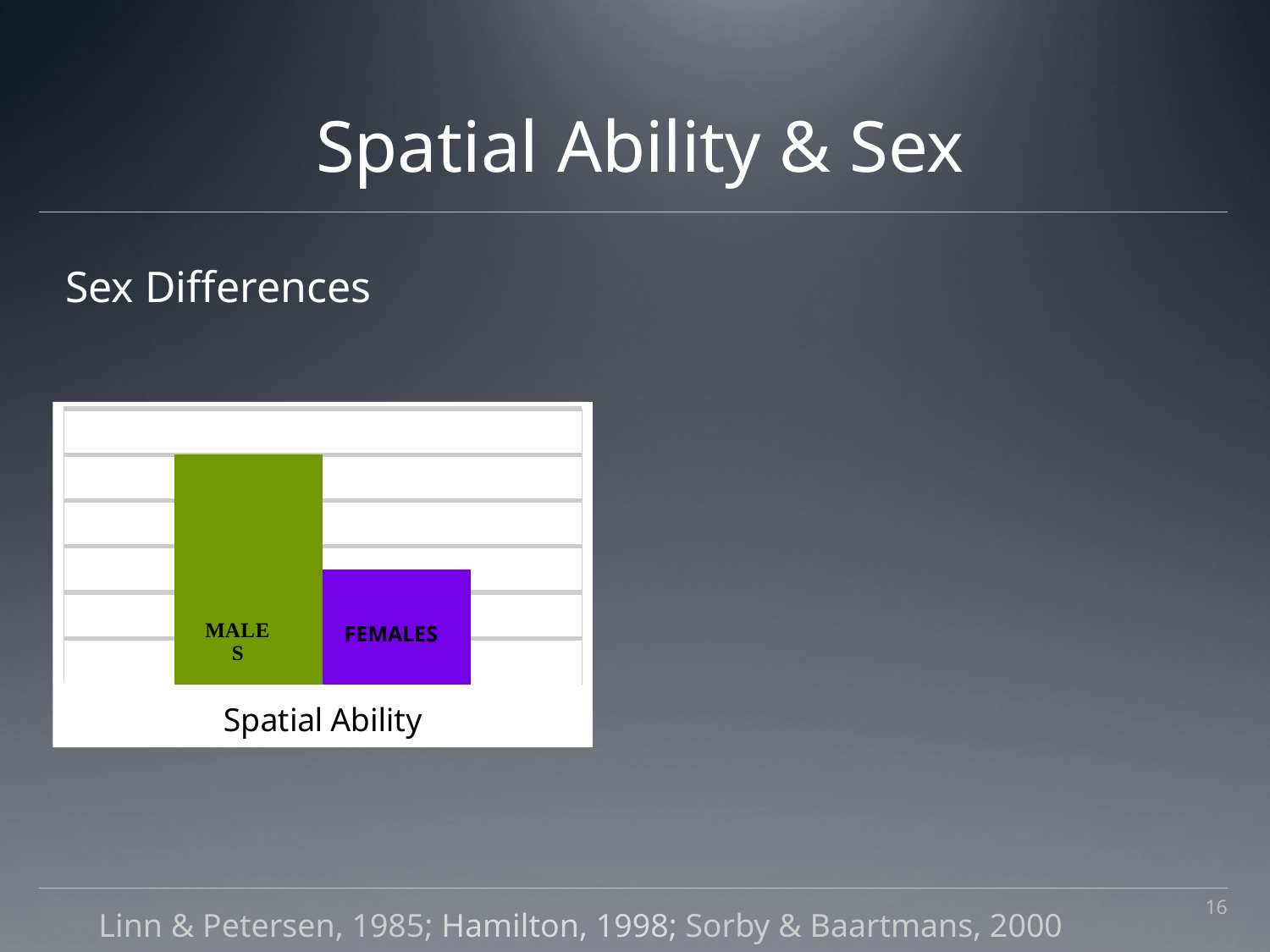
Which bar is taller, MALES or FEMALES? MALES What kind of chart is shown on the slide? bar chart What colour is the FEMALES bar? purple How many bars are plotted in the chart? 2 Which bar is the tallest in the chart? MALES What label appears below the bars on the category axis? Spatial Ability Which bar is the shortest in the chart? FEMALES